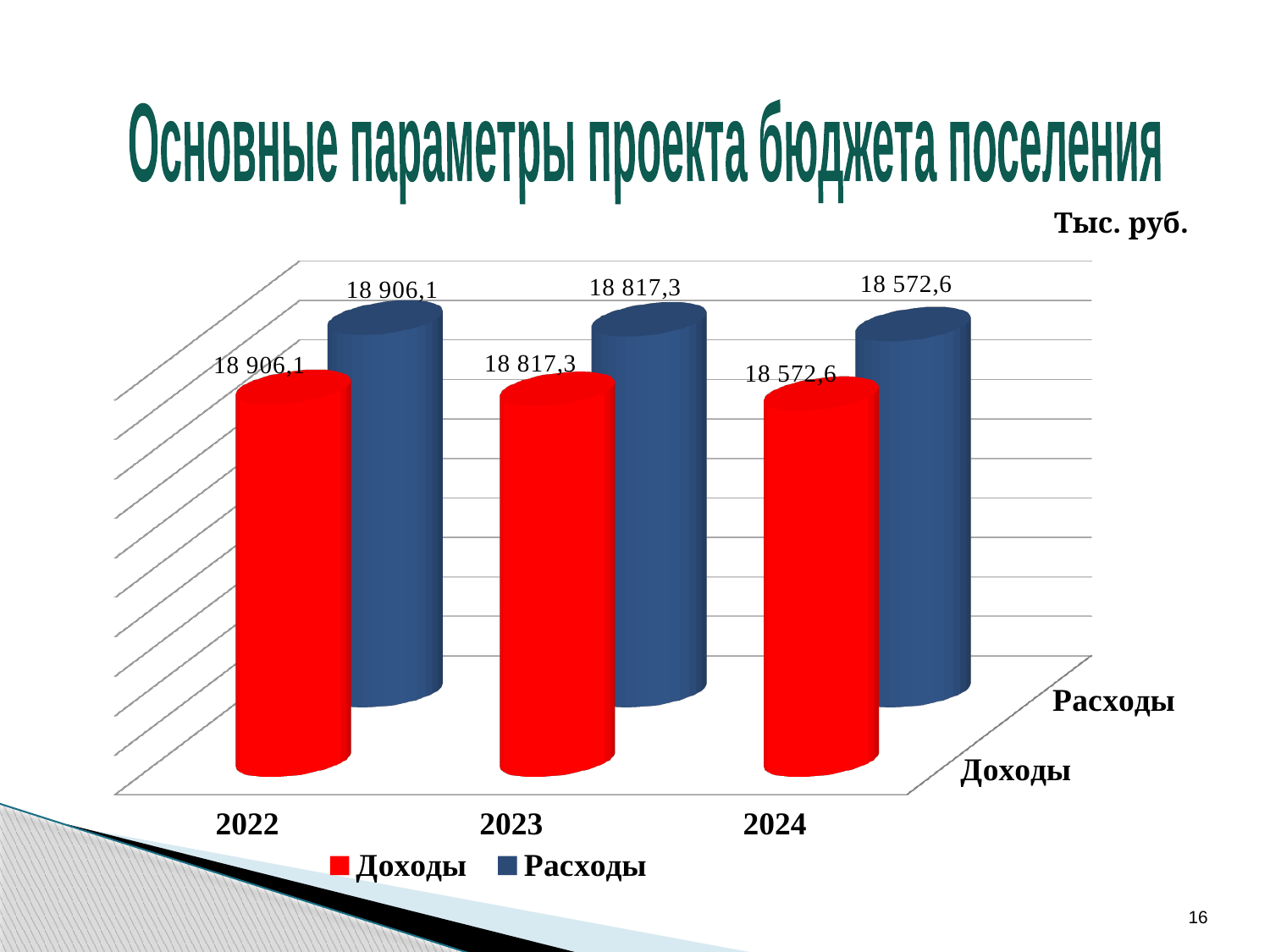
What is the value of Доходы for 2022? 18 906,1 In which year is Доходы highest? 2022 How many series does the legend list? 2 Which is larger: Доходы in 2022 or Доходы in 2023? Доходы in 2022 What is the value of Расходы for 2024? 18 572,6 What is the difference between Доходы in 2022 and Доходы in 2024? 333,5 How many years are shown on the x axis? 3 What is the value of Доходы for 2024? 18 572,6 What is the difference between Расходы in 2023 and Расходы in 2024? 244,7 What is the value of Расходы for 2023? 18 817,3 In which year is Расходы lowest? 2024 Do the Расходы values rise or fall from 2022 to 2024? fall